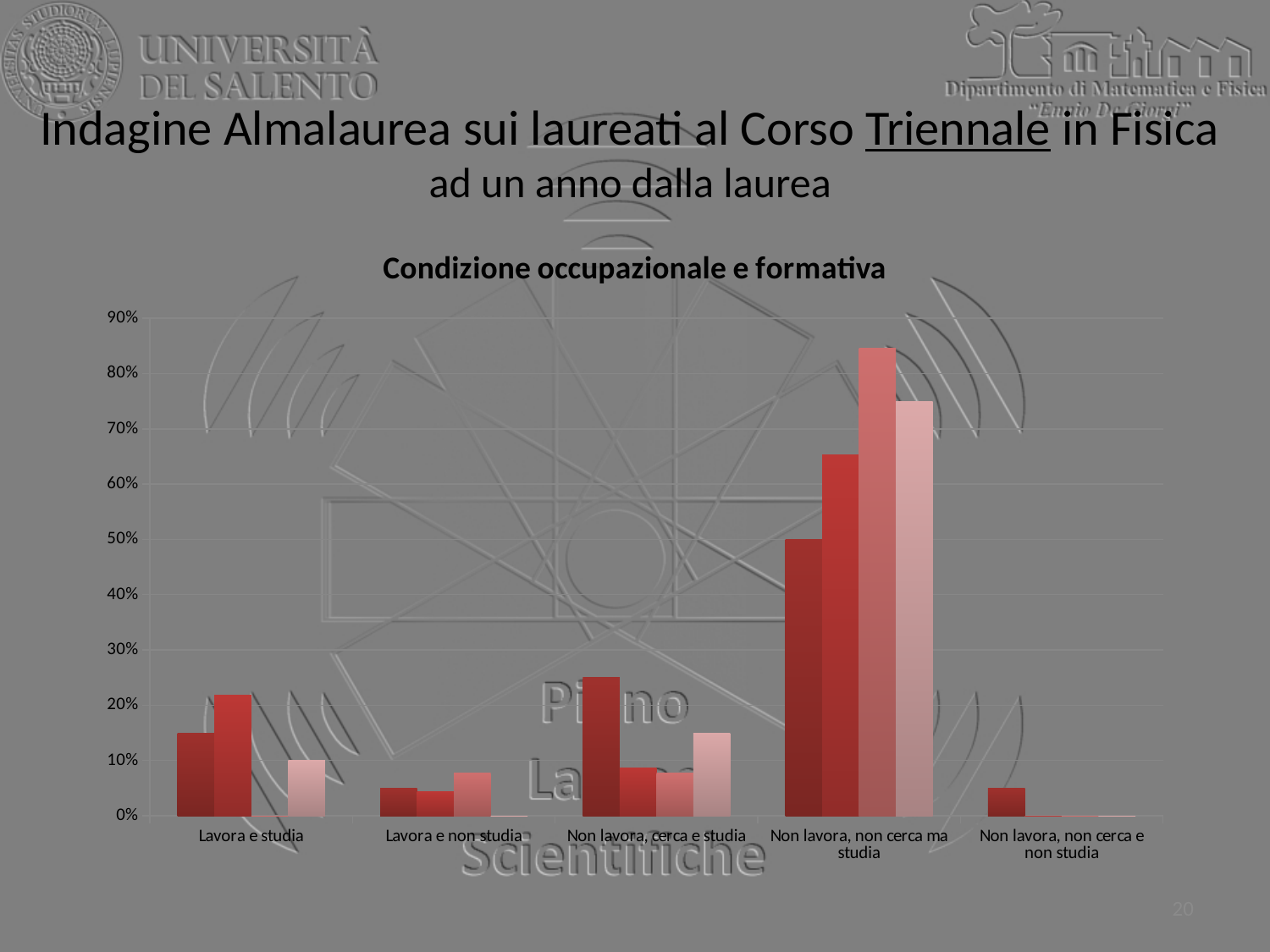
How many bars are plotted for each category in the chart? 4 Which category has a taller highest bar: 'Lavora e studia' or 'Lavora e non studia'? Lavora e studia Which category has the tallest bar in the chart? Non lavora, non cerca ma studia Is the tallest bar for 'Non lavora, non cerca e non studia' greater or less than 10%? less What is the highest value shown on the vertical axis of the chart? 90% Is the tallest bar for 'Non lavora, cerca e studia' greater or less than 20%? greater Is the tallest bar for 'Lavora e non studia' greater or less than 10%? less What is the title of the chart? Condizione occupazionale e formativa Which category has the lowest bars overall in the chart? Non lavora, non cerca e non studia What kind of chart is shown on the slide? bar chart How many categories are shown on the x axis of the chart? 5